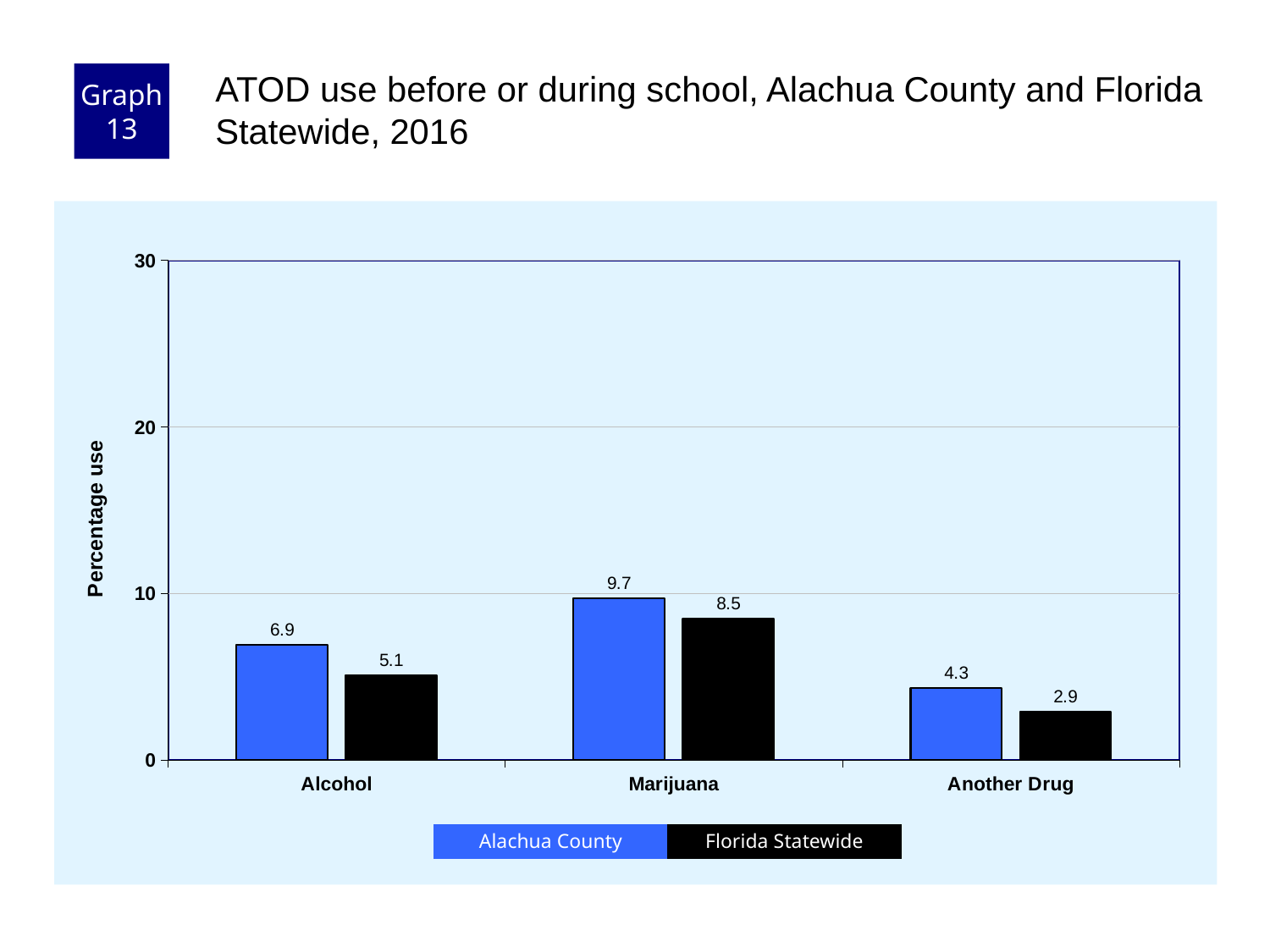
What is the Alachua County value for Marijuana? 9.7 What is the difference between the Alachua County and Florida Statewide values for Alcohol? 1.8 Which category has the lowest Florida Statewide value? Another Drug What is the Florida Statewide value for Another Drug? 2.9 Which is larger for Another Drug: Alachua County or Florida Statewide? Alachua County What kind of chart is shown on the slide? bar chart Is the Florida Statewide value for Marijuana greater or less than 10? less What is the Florida Statewide value for Alcohol? 5.1 What is the difference between the Alachua County values for Marijuana and Another Drug? 5.4 How many categories are shown on the x axis? 3 How many series does the legend list? 2 Which category has the highest Alachua County value? Marijuana